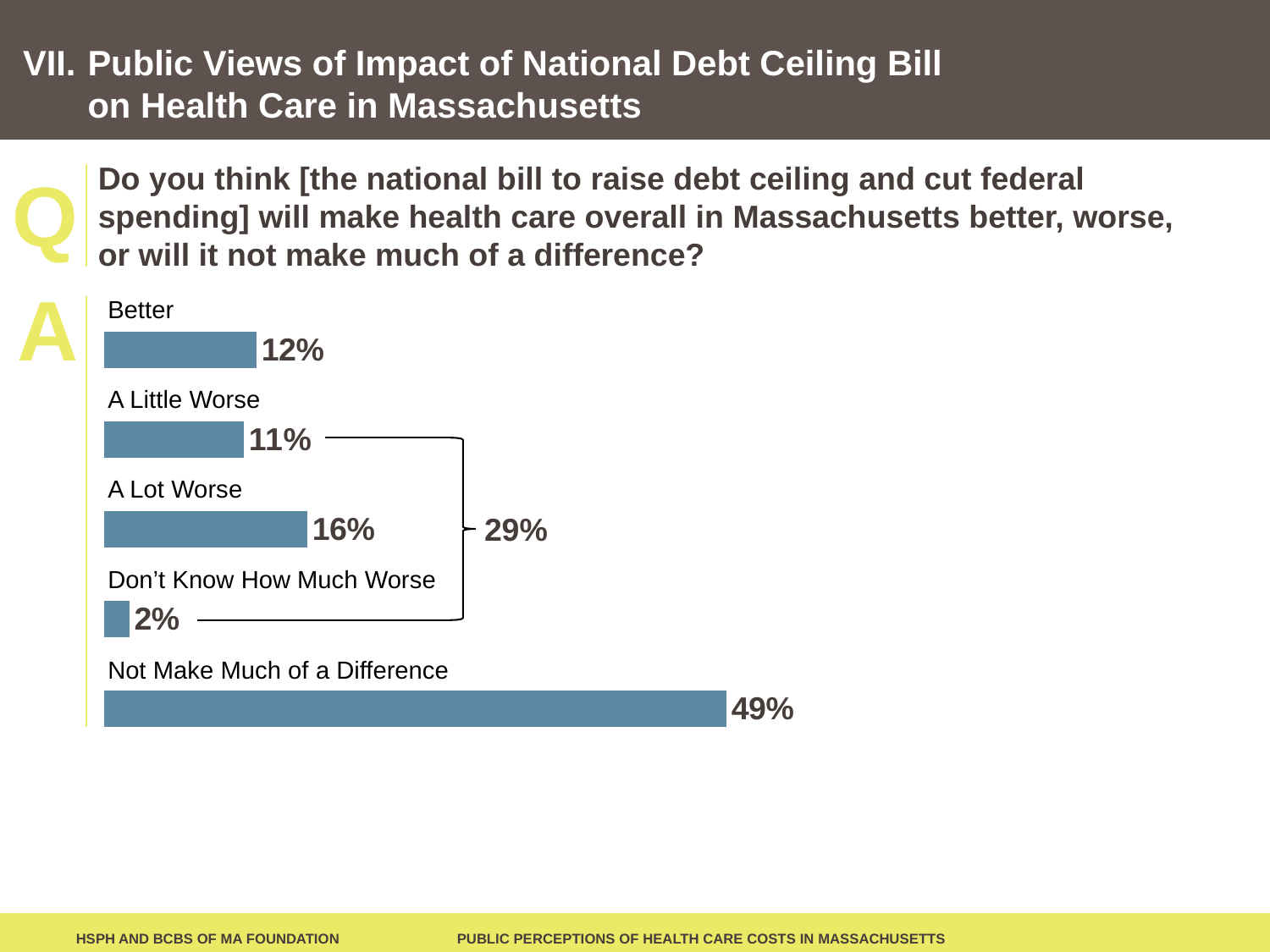
What percentage of respondents said the bill will make health care in Massachusetts better? 12% What percentage of respondents said the bill will make health care a lot worse? 16% What is the combined percentage shown for all the 'worse' responses? 29% What is the difference in percentage points between 'Not Make Much of a Difference' and 'Better'? 37 What percentage of respondents said the bill will not make much of a difference? 49% How many response categories are shown as bars in the chart? 5 Which is larger, the percentage for 'A Lot Worse' or for 'A Little Worse'? A Lot Worse Which response category has the highest percentage? Not Make Much of a Difference Which response category has the lowest percentage? Don't Know How Much Worse What percentage of respondents said the bill will make health care worse but don't know how much worse? 2% What percentage of respondents said the bill will make health care a little worse? 11% What type of chart is shown on the slide? Bar chart